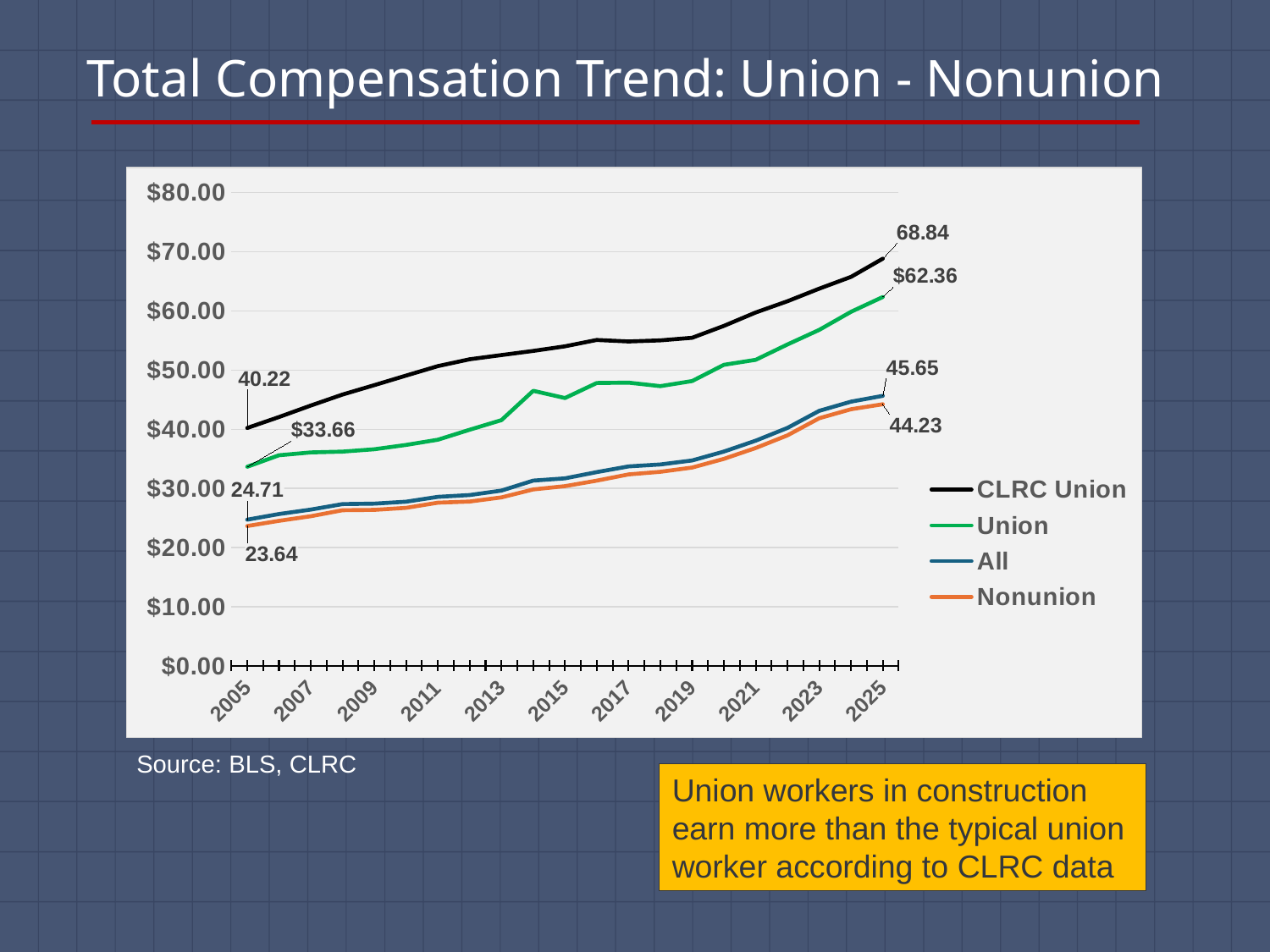
What is the value of the Nonunion series at the end of the chart (2025)? 44.23 What is the difference between the CLRC Union value and the Union value in 2025? 6.48 Which series has the highest value in 2025? CLRC Union Do the values of the Nonunion series rise or fall from 2005 to 2025? rise Which is larger in 2025, the All value or the Nonunion value? All What is the value of the CLRC Union series at the end of the chart (2025)? 68.84 What is the title of the chart slide? Total Compensation Trend: Union - Nonunion How many series does the legend list? 4 What is the value of the All series at the start of the chart (2005)? 24.71 What type of chart is shown on the slide? line chart Which series has the lowest value in 2005? Nonunion What is the value of the Union series at the start of the chart (2005)? $33.66